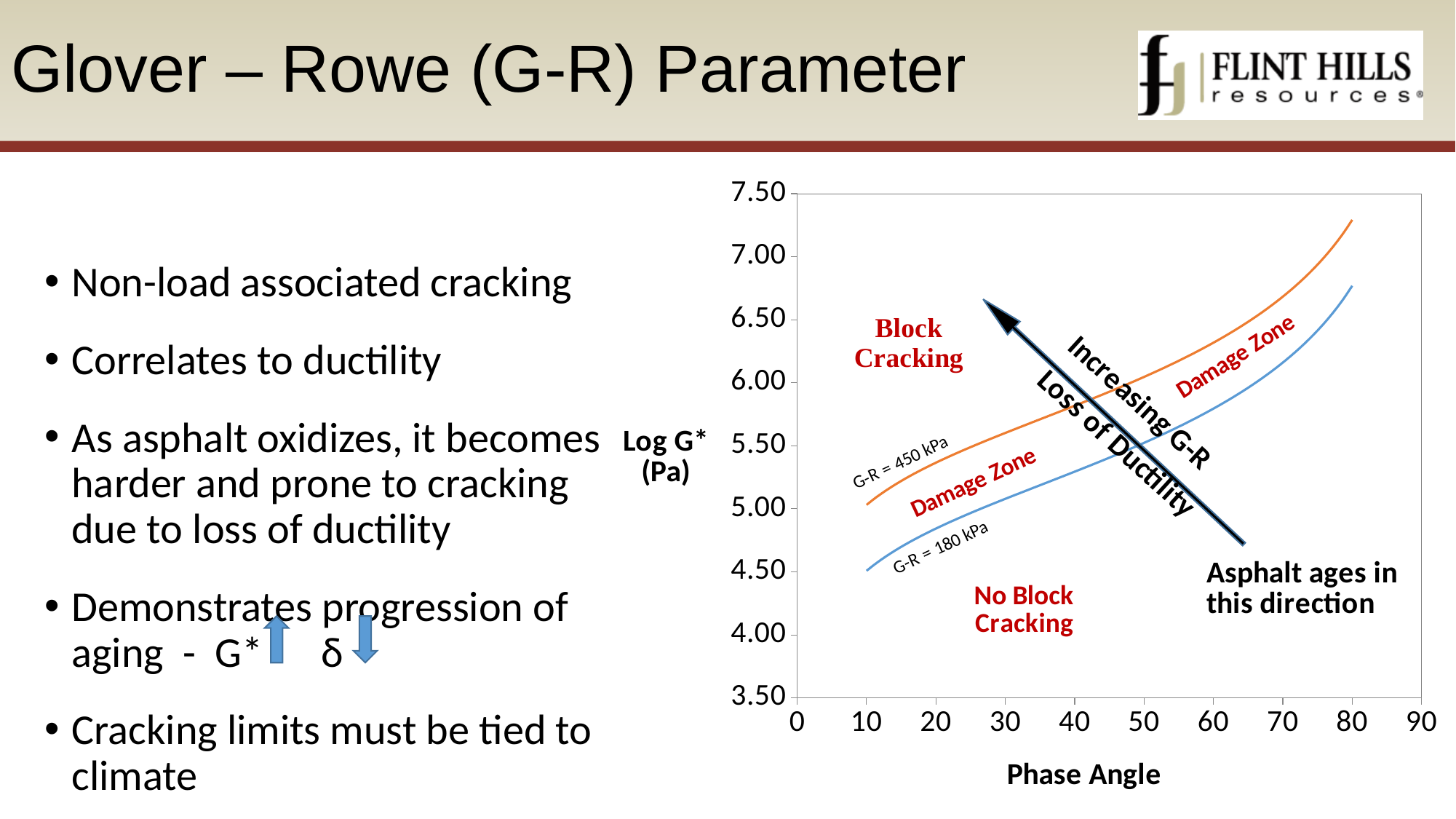
Is the value of the G-R = 180 kPa curve at a phase angle of 10 greater or less than 5.00? less Is the value of the G-R = 180 kPa curve at a phase angle of 80 greater or less than 7.00? less Is the value of the G-R = 180 kPa curve at a phase angle of 80 greater or less than 6.50? greater What is the label of the y axis of the chart? Log G* (Pa) Do the curves rise or fall as the phase angle increases? rise How many curves are plotted on the chart? 2 What is the label of the x axis of the chart? Phase Angle Which curve lies higher on the chart, G-R = 450 kPa or G-R = 180 kPa? G-R = 450 kPa What kind of chart is shown on the slide? line chart What is the highest tick value shown on the y axis of the chart? 7.50